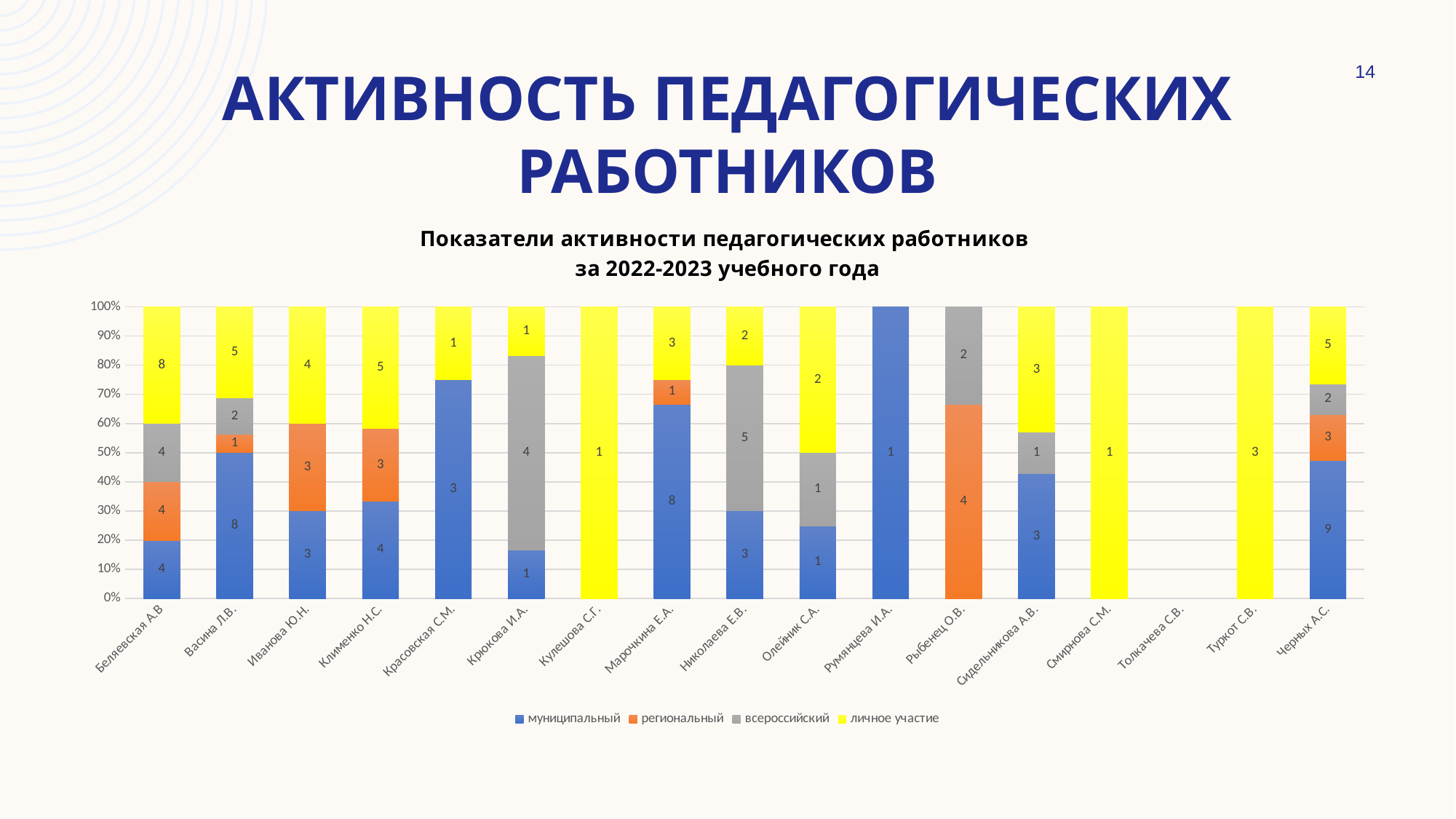
What is the value of the всероссийский segment for Николаева Е.В.? 5 What is the total of all segments in the bar for Беляевская А.В? 20 Which teacher has the highest муниципальный value? Черных А.С. What is the value of the региональный segment for Рыбенец О.В.? 4 How many series does the legend list? 4 What is the difference between the личное участие values for Беляевская А.В and Иванова Ю.Н.? 4 Which is larger: the муниципальный value for Васина Л.В. or for Сидельникова А.В.? Васина Л.В. How many teachers (categories) are listed along the x axis? 17 What is the value of the муниципальный segment for Черных А.С.? 9 What is the total of all segments in the bar for Васина Л.В.? 16 What is the value of the личное участие segment for Беляевская А.В? 8 What kind of chart is shown on the slide? Stacked bar chart